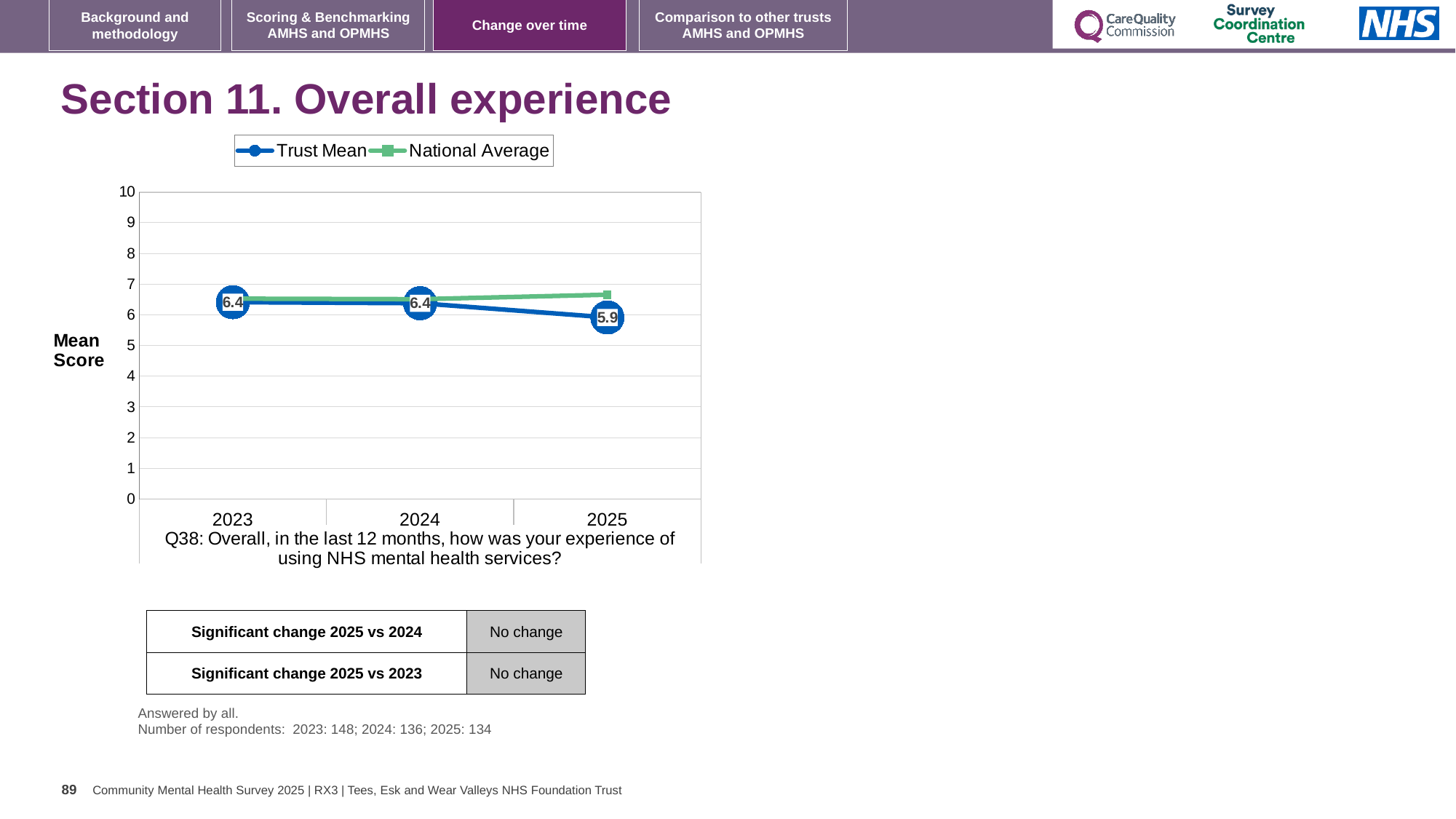
What is the Trust Mean value for 2023? 6.4 How many years are plotted on the x axis? 3 In which year is the Trust Mean lowest? 2025 What is the Trust Mean value for 2024? 6.4 Does the Trust Mean rise or fall from 2024 to 2025? Fall What is the Trust Mean value for 2025? 5.9 Is the National Average value for 2025 greater or less than 6? greater In 2025, which is larger: the Trust Mean or the National Average? National Average What is the difference between the Trust Mean in 2023 and in 2025? 0.5 What kind of chart is shown on the slide? Line chart Is the National Average value for 2023 greater or less than 7? less How many series does the legend list? 2